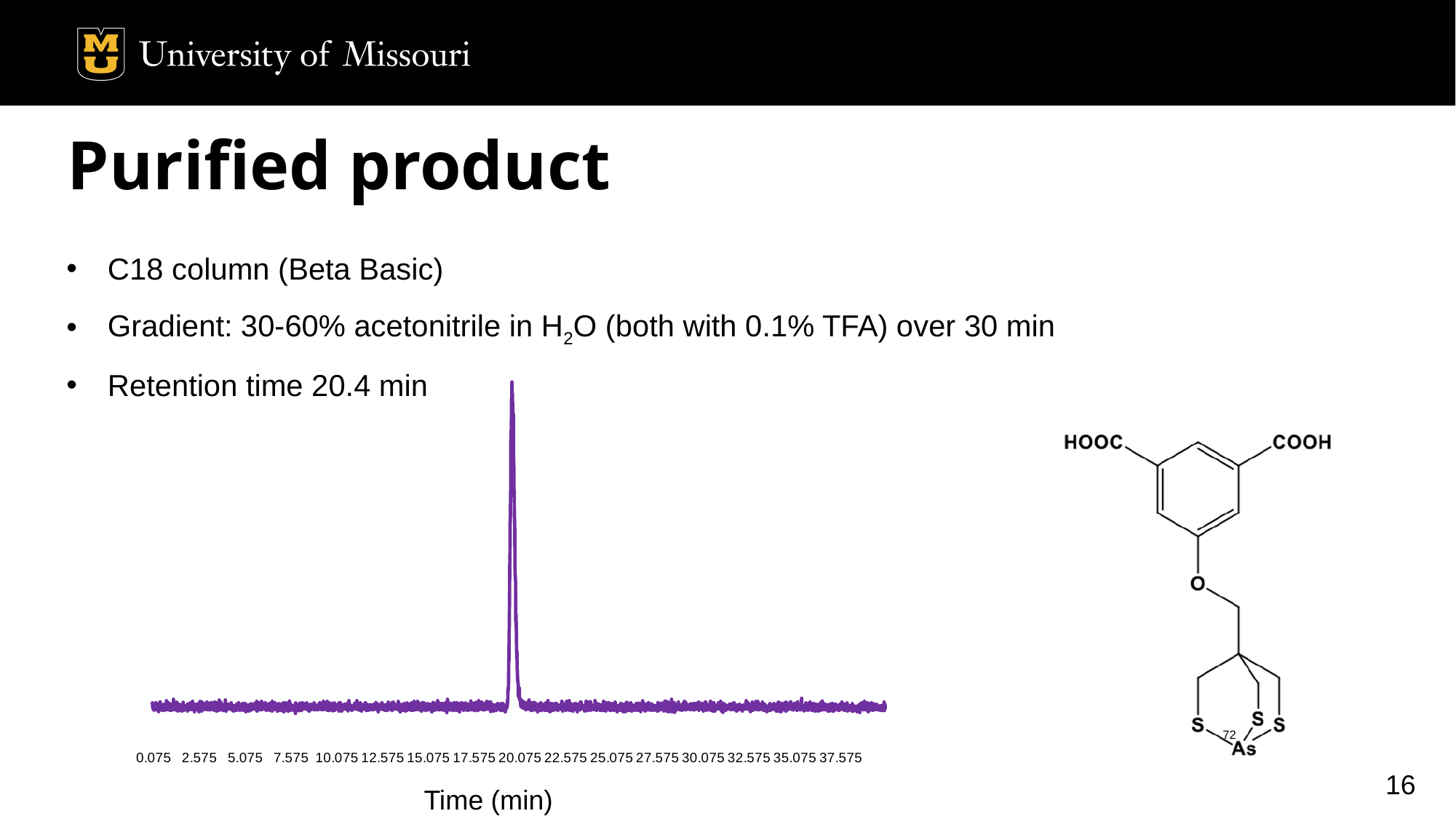
Is the time at which the peak occurs greater or less than 22.575 min? less What is the label of the x axis of the chart? Time (min) Which x-axis tick label is closest to the peak of the chromatogram? 20.075 What is the first tick label on the x axis of the chart? 0.075 How many tick labels are shown on the x axis of the chart? 16 Is the time at which the peak occurs greater or less than 17.575 min? greater How many major peaks does the chromatogram show? 1 What colour is the line plotted in the chart? purple What kind of chart is shown on the slide? line chart What is the last tick label on the x axis of the chart? 37.575 Is the signal at 10.075 min higher or lower than the signal at the peak near 20.075 min? lower